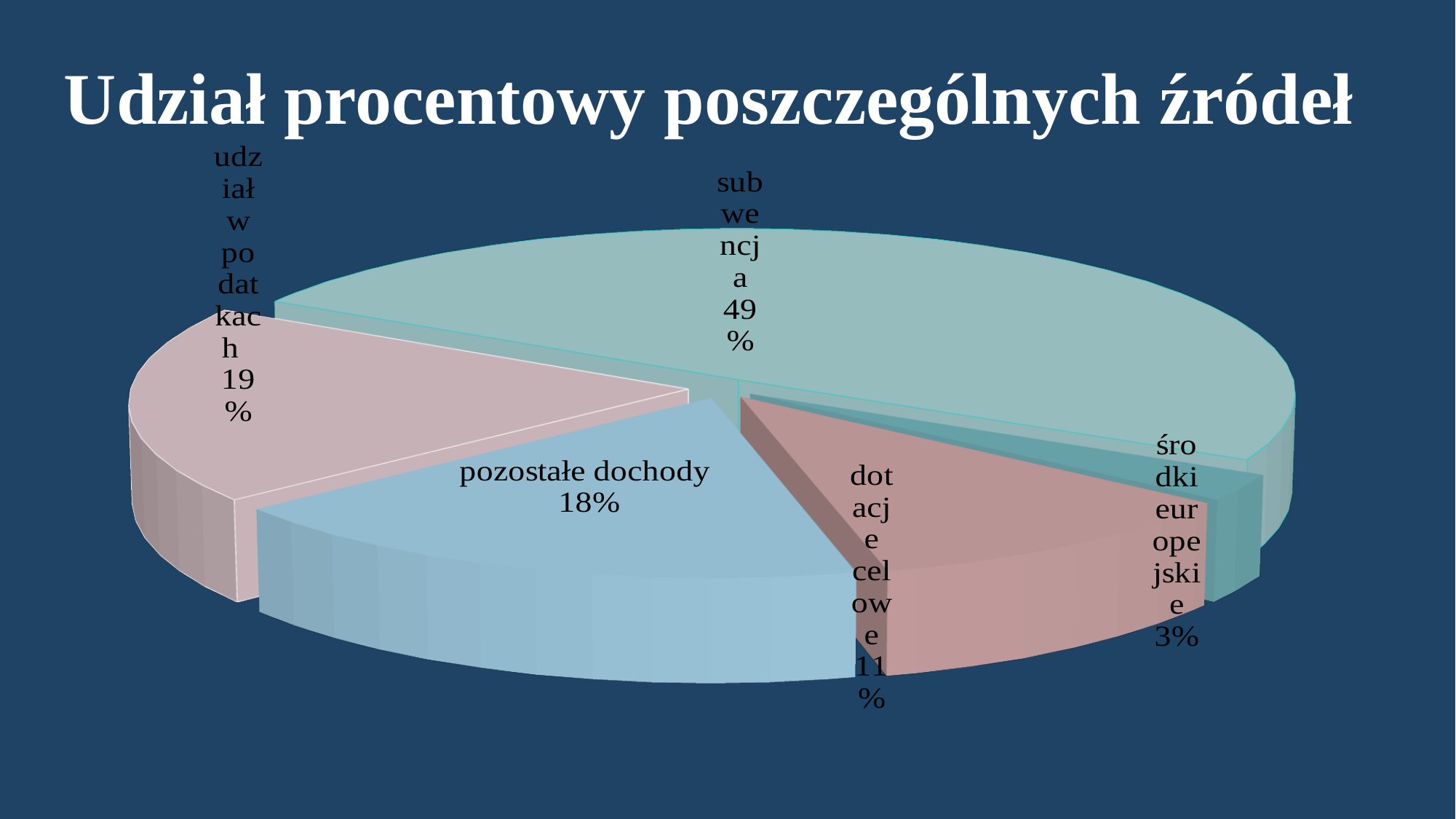
What percentage is shown for pozostałe dochody? 18% Which source has the smallest share of the pie? środki europejskie How many slices does the pie chart have? 5 Which is larger, the share for udział w podatkach or the share for dotacje celowe? udział w podatkach What kind of chart is shown on the slide? pie chart What percentage is shown for subwencja? 49% What percentage is shown for dotacje celowe? 11% What is the title of the chart on the slide? Udział procentowy poszczególnych źródeł What percentage is shown for środki europejskie? 3% What is the difference in percentage points between subwencja and dotacje celowe? 38 Which source has the largest share of the pie? subwencja What percentage is shown for udział w podatkach? 19%